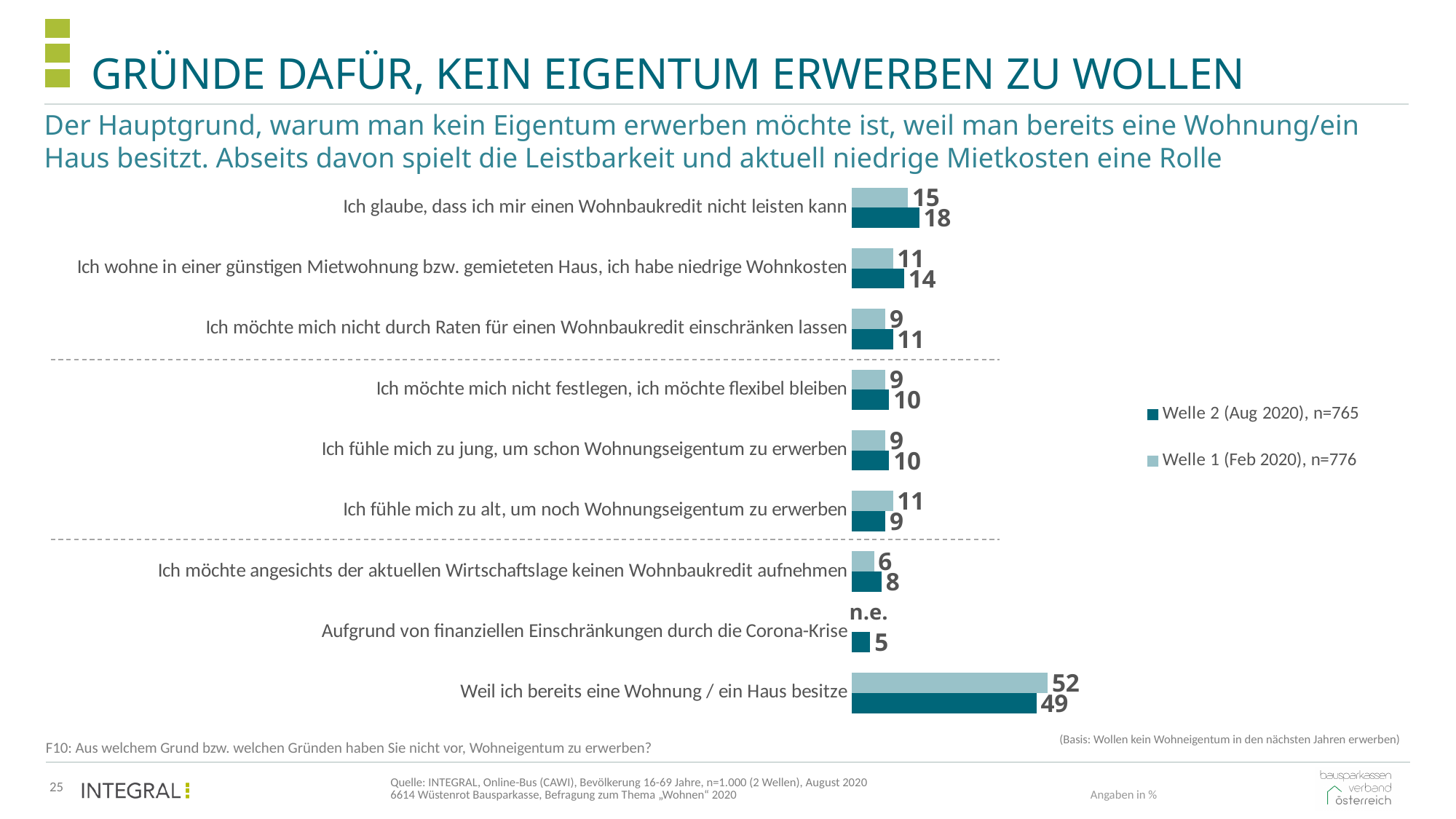
What kind of chart is shown on the slide? Bar chart What is the difference between the Welle 1 and Welle 2 values for "Weil ich bereits eine Wohnung / ein Haus besitze"? 3 Which reason has the highest Welle 2 (Aug 2020) value? Weil ich bereits eine Wohnung / ein Haus besitze What is shown instead of a Welle 1 (Feb 2020) value for "Aufgrund von finanziellen Einschränkungen durch die Corona-Krise"? n.e. How many reasons (categories) are shown in the chart? 9 How many series does the legend list? 2 For "Ich wohne in einer günstigen Mietwohnung bzw. gemieteten Haus, ich habe niedrige Wohnkosten", which wave has the larger value, Welle 1 or Welle 2? Welle 2 What is the Welle 1 (Feb 2020) value for "Ich fühle mich zu alt, um noch Wohnungseigentum zu erwerben"? 11 Which reason has the lowest Welle 1 (Feb 2020) value among those with a printed number? Ich möchte angesichts der aktuellen Wirtschaftslage keinen Wohnbaukredit aufnehmen What is the Welle 1 (Feb 2020) value for "Weil ich bereits eine Wohnung / ein Haus besitze"? 52 What is the Welle 2 (Aug 2020) value for "Ich glaube, dass ich mir einen Wohnbaukredit nicht leisten kann"? 18 What is the Welle 2 (Aug 2020) value for "Aufgrund von finanziellen Einschränkungen durch die Corona-Krise"? 5